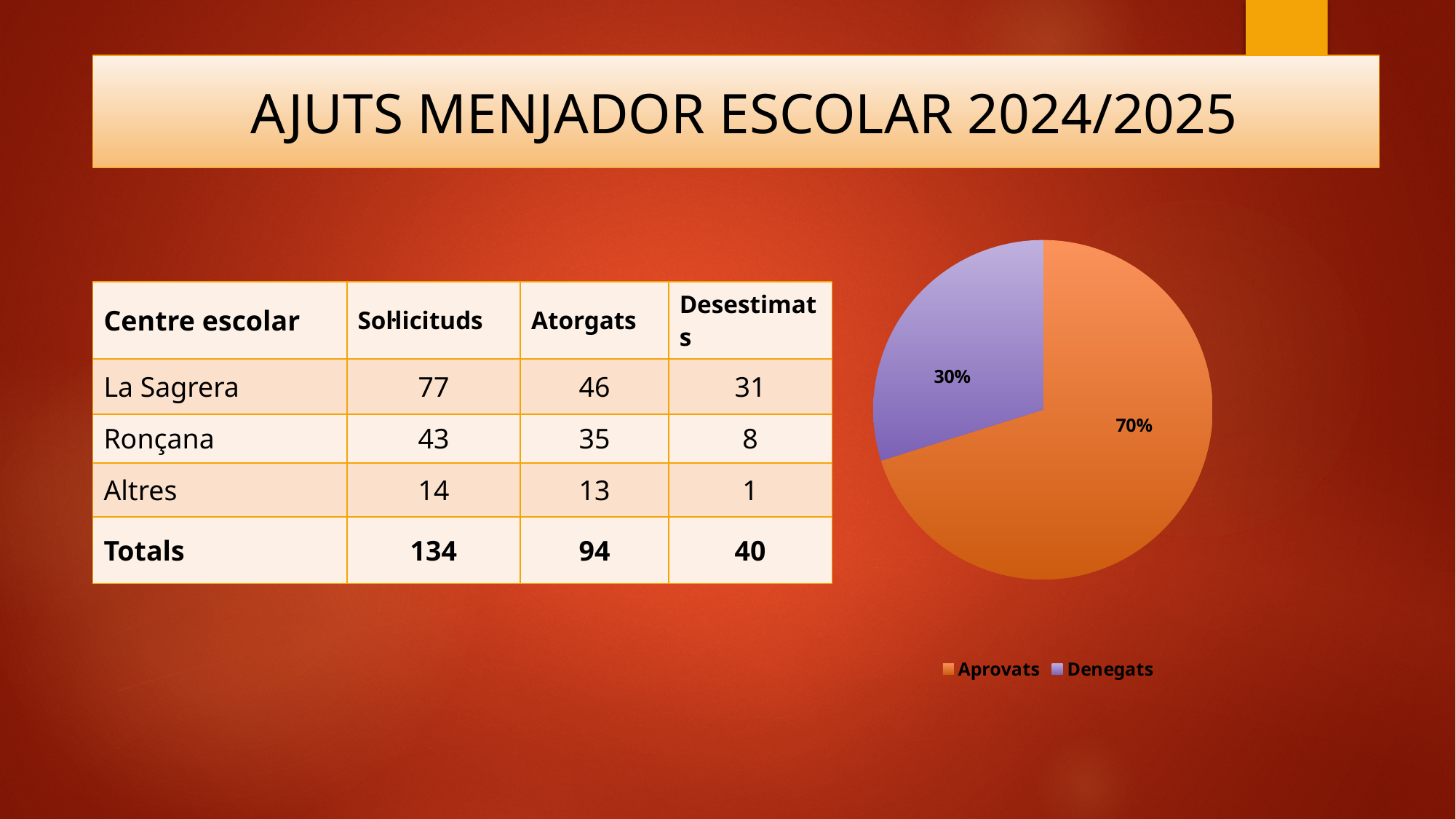
Which slice of the pie chart is the largest? Aprovats What share of the pie chart is Aprovats? 70% What is the difference in percentage points between the Aprovats and Denegats slices? 40 What kind of chart is shown on the slide? pie chart How many entries does the pie chart's legend list? 2 How many slices does the pie chart have? 2 What colour is the Denegats slice in the pie chart? purple Which is larger in the pie chart, Aprovats or Denegats? Aprovats What share of the pie chart is Denegats? 30% Which slice of the pie chart is the smallest? Denegats What colour is the Aprovats slice in the pie chart? orange